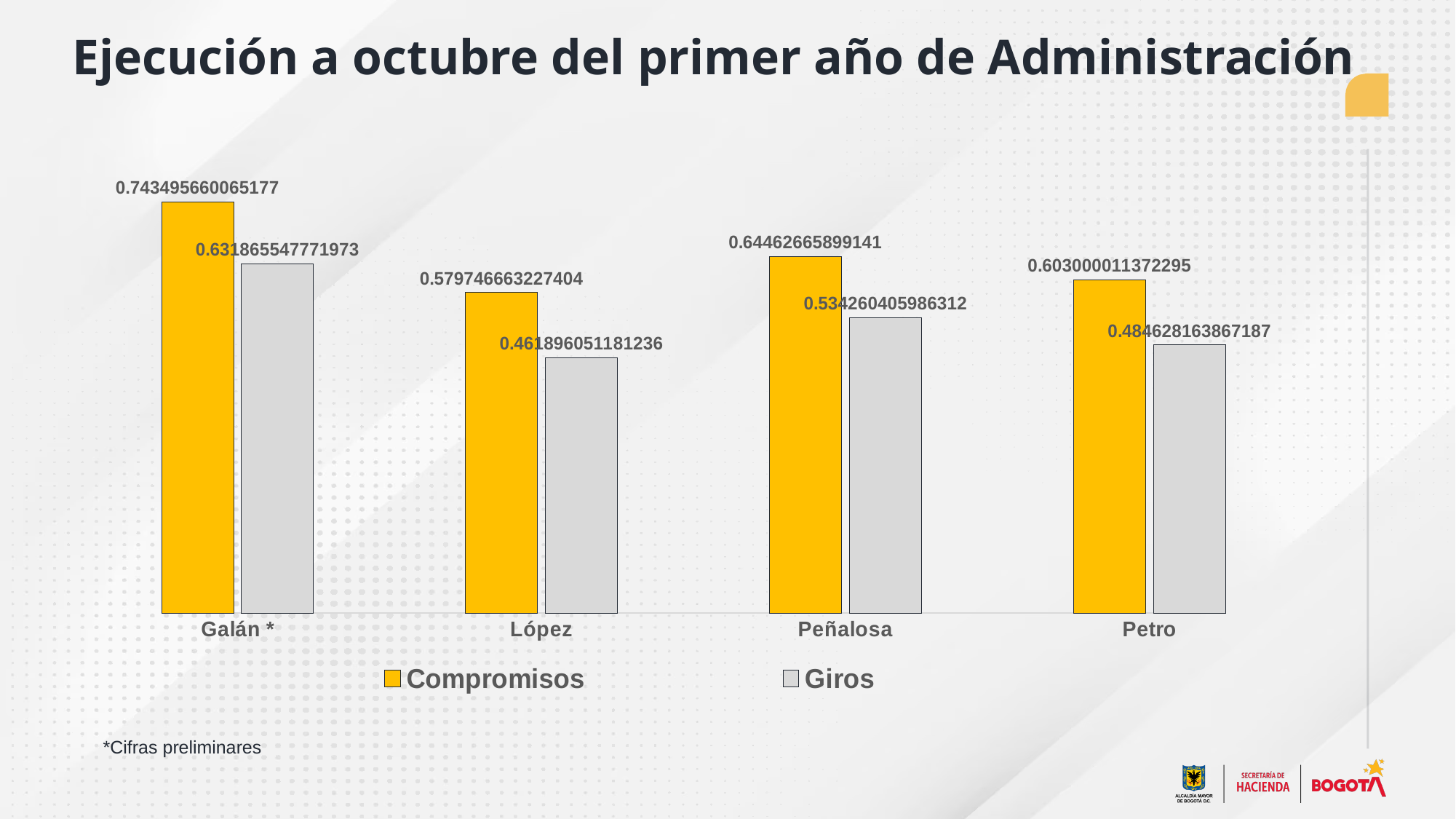
Which administration has the higher Giros value, Peñalosa or Petro? Peñalosa What is the Giros value for López? 0.461896051181236 Which is larger for Petro: Compromisos or Giros? Compromisos What is the difference between the Compromisos and Giros values for Galán *? 0.111630112293204 What type of chart is shown on the slide? Bar chart What is the Compromisos value for Peñalosa? 0.64462665899141 Which administration has the highest Compromisos value? Galán * How many series does the legend list? 2 How many administrations are shown on the x axis? 4 Which administration has the lowest Giros value? López What is the Giros value for Petro? 0.484628163867187 What is the Compromisos value for Galán *? 0.743495660065177